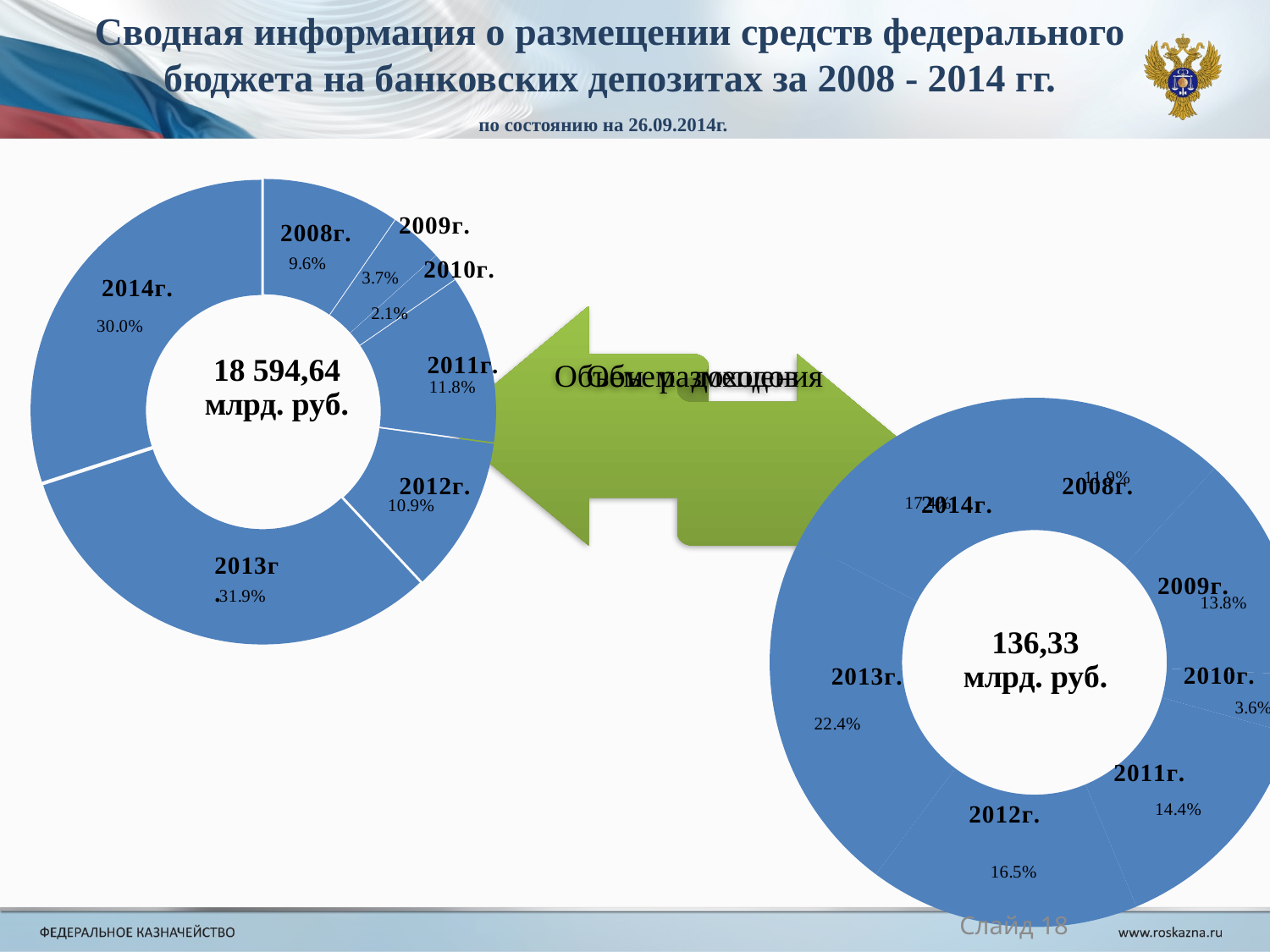
In the right doughnut chart (136,33 млрд. руб.), what share is shown for 2013г.? 22.4% What total value is printed in the centre of the left doughnut chart? 18 594,64 млрд. руб. In the left doughnut chart (18 594,64 млрд. руб.), what share is shown for 2010г.? 2.1% How many year segments does the left doughnut chart (18 594,64 млрд. руб.) contain? 7 In the left doughnut chart (18 594,64 млрд. руб.), what share is shown for 2014г.? 30.0% In the left doughnut chart (18 594,64 млрд. руб.), which year has the largest share? 2013г In the right doughnut chart (136,33 млрд. руб.), what share is shown for 2010г.? 3.6% What type of chart is used on the left side of the slide? Doughnut (pie) chart In the right doughnut chart (136,33 млрд. руб.), which year has the smallest share? 2010г. In the left doughnut chart (18 594,64 млрд. руб.), how much larger is the share for 2011г. than for 2012г.? 0.9% In the right doughnut chart (136,33 млрд. руб.), which share is larger: 2011г. or 2009г.? 2011г. In the left doughnut chart (18 594,64 млрд. руб.), which year has the smallest share? 2010г.